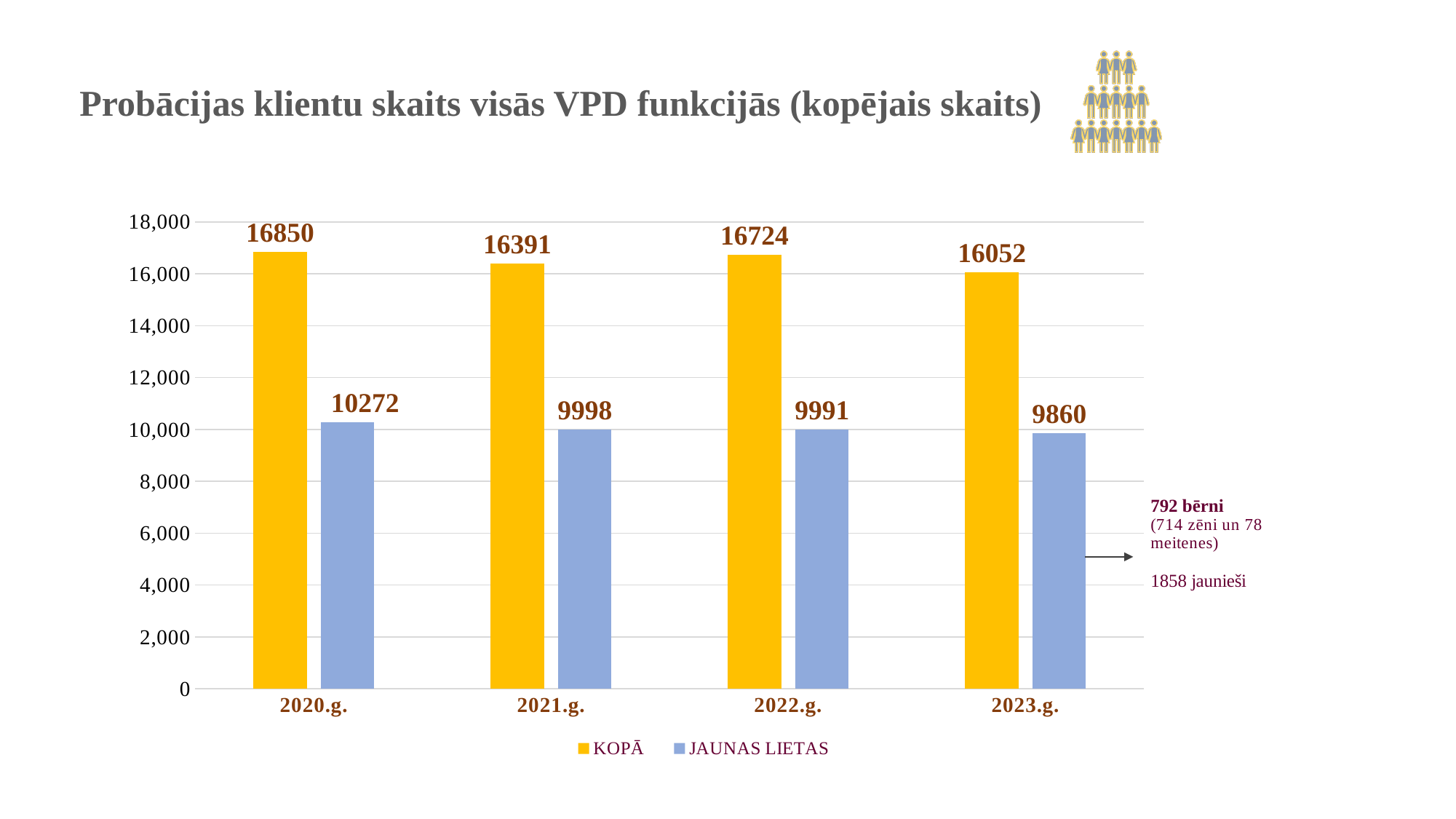
Which year has the highest KOPĀ value? 2020.g. What is the JAUNAS LIETAS value for 2023.g.? 9860 Is the JAUNAS LIETAS value for 2020.g. greater or less than 10,000? greater How many years are shown on the x axis? 4 What kind of chart is shown on the slide? bar chart How many series does the legend list? 2 What is the JAUNAS LIETAS value for 2021.g.? 9998 Which colour represents the KOPĀ series? yellow Which year has the lowest JAUNAS LIETAS value? 2023.g. Which is larger, the KOPĀ value for 2021.g. or for 2022.g.? 2022.g. What is the KOPĀ value for 2020.g.? 16850 What is the difference between the KOPĀ values for 2020.g. and 2023.g.? 798